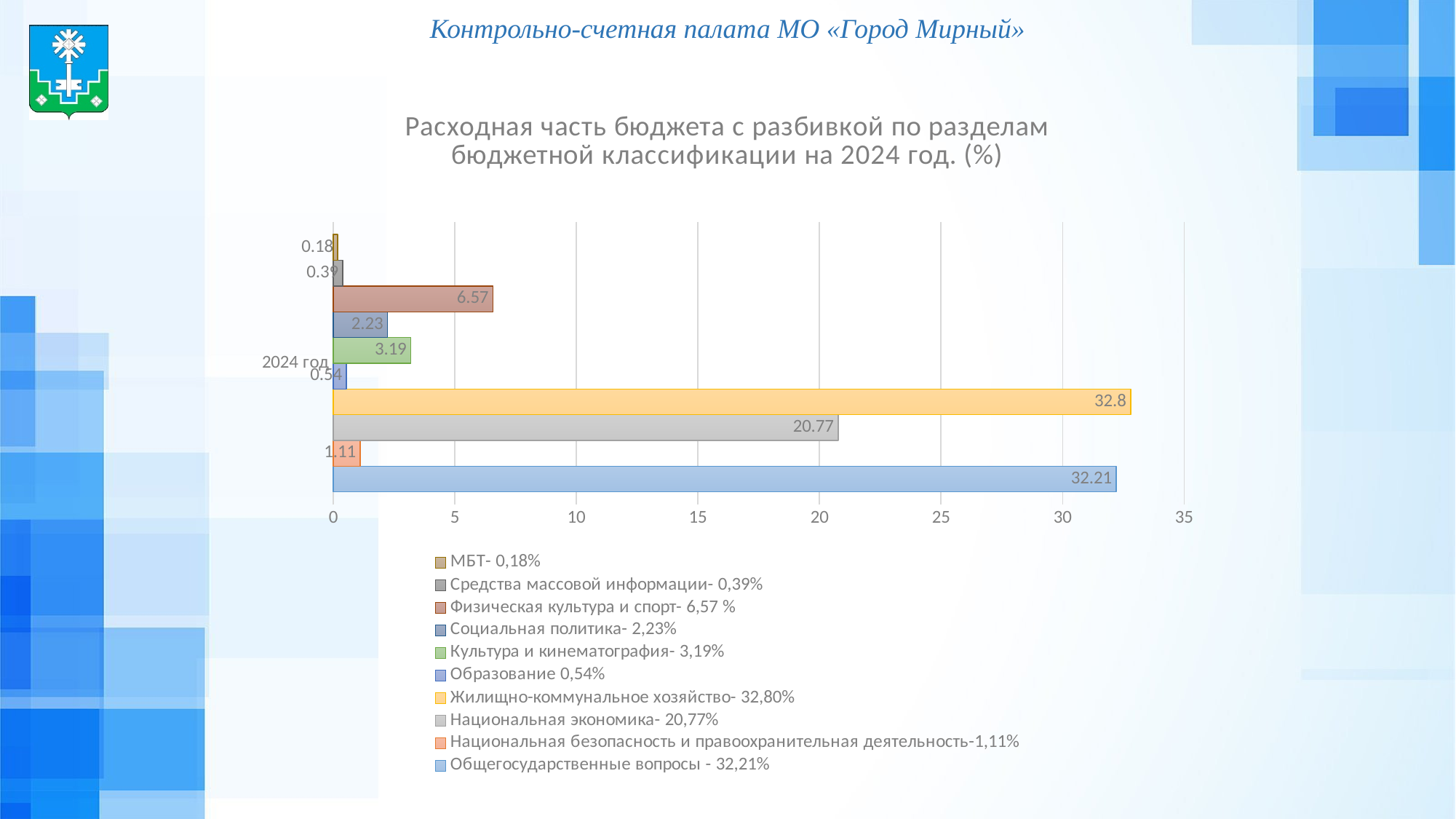
Which series has the smallest bar in the chart? МБТ What is the value of the bar for Национальная экономика? 20.77 How many series does the legend list? 10 Which is larger: the value for Социальная политика or the value for Культура и кинематография? Культура и кинематография What type of chart is shown on the slide? bar chart What category label is shown on the vertical axis of the chart? 2024 год Is the value for Национальная экономика greater or less than 20? greater What is the difference between the values for Жилищно-коммунальное хозяйство and Общегосударственные вопросы? 0.59 What is the value of the bar for Культура и кинематография? 3.19 What is the value of the bar for Физическая культура и спорт? 6.57 What is the value of the bar for Жилищно-коммунальное хозяйство? 32.8 Which series has the largest bar in the chart? Жилищно-коммунальное хозяйство